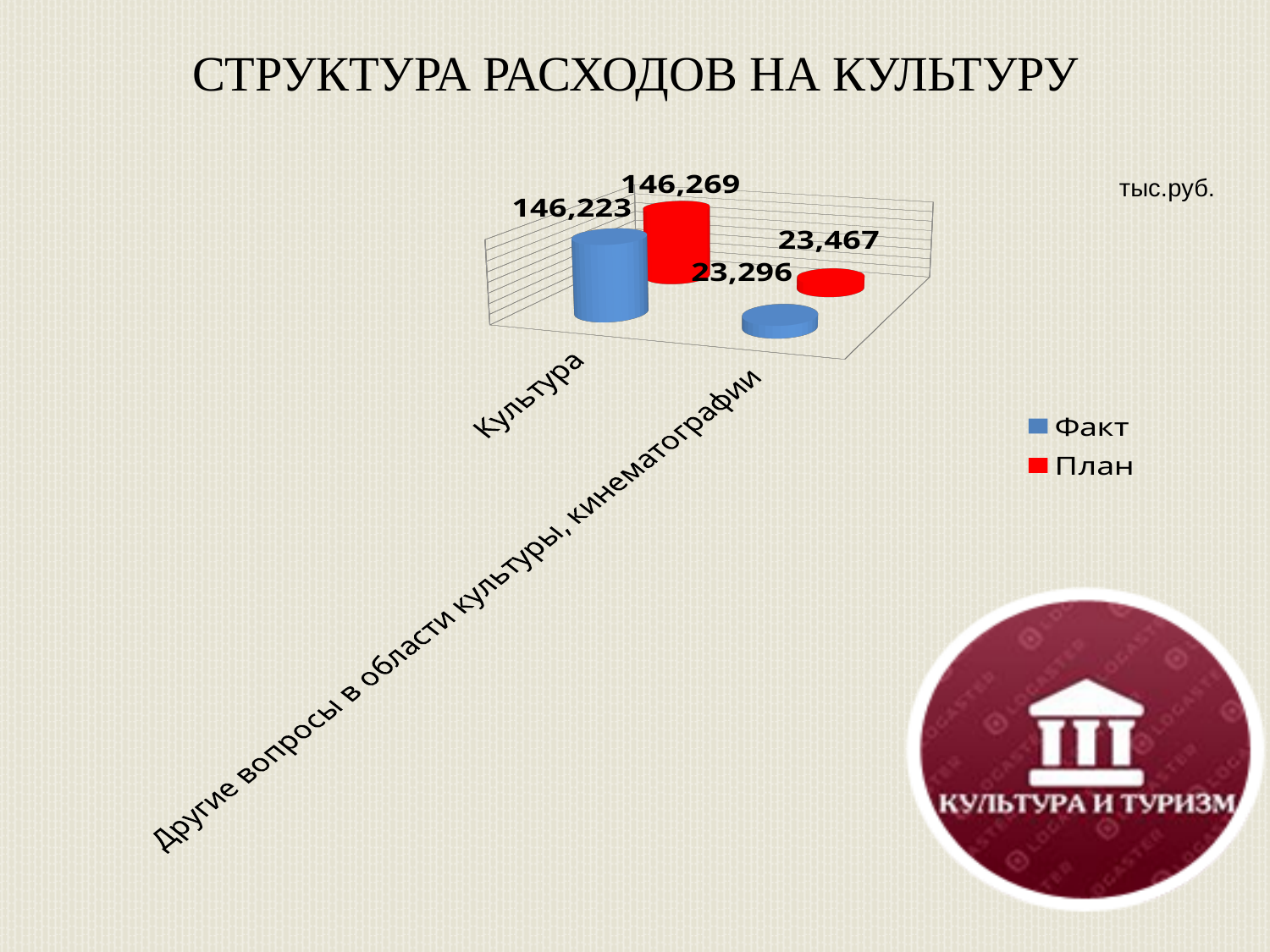
What is the Факт value for Культура? 146,223 What is the План value for Другие вопросы в области культуры, кинематографии? 23,467 How many categories are shown on the chart? 2 How many series does the legend list? 2 What is the Факт value for Другие вопросы в области культуры, кинематографии? 23,296 What is the difference between the План and Факт values for Другие вопросы в области культуры, кинематографии? 0,171 What is the План value for Культура? 146,269 Which is larger: the Факт value for Культура or the Факт value for Другие вопросы в области культуры, кинематографии? Культура Which category has the highest Факт value? Культура What is the difference between the План and Факт values for Культура? 0,046 Which category has the lowest План value? Другие вопросы в области культуры, кинематографии What kind of chart is shown on the slide? Bar chart